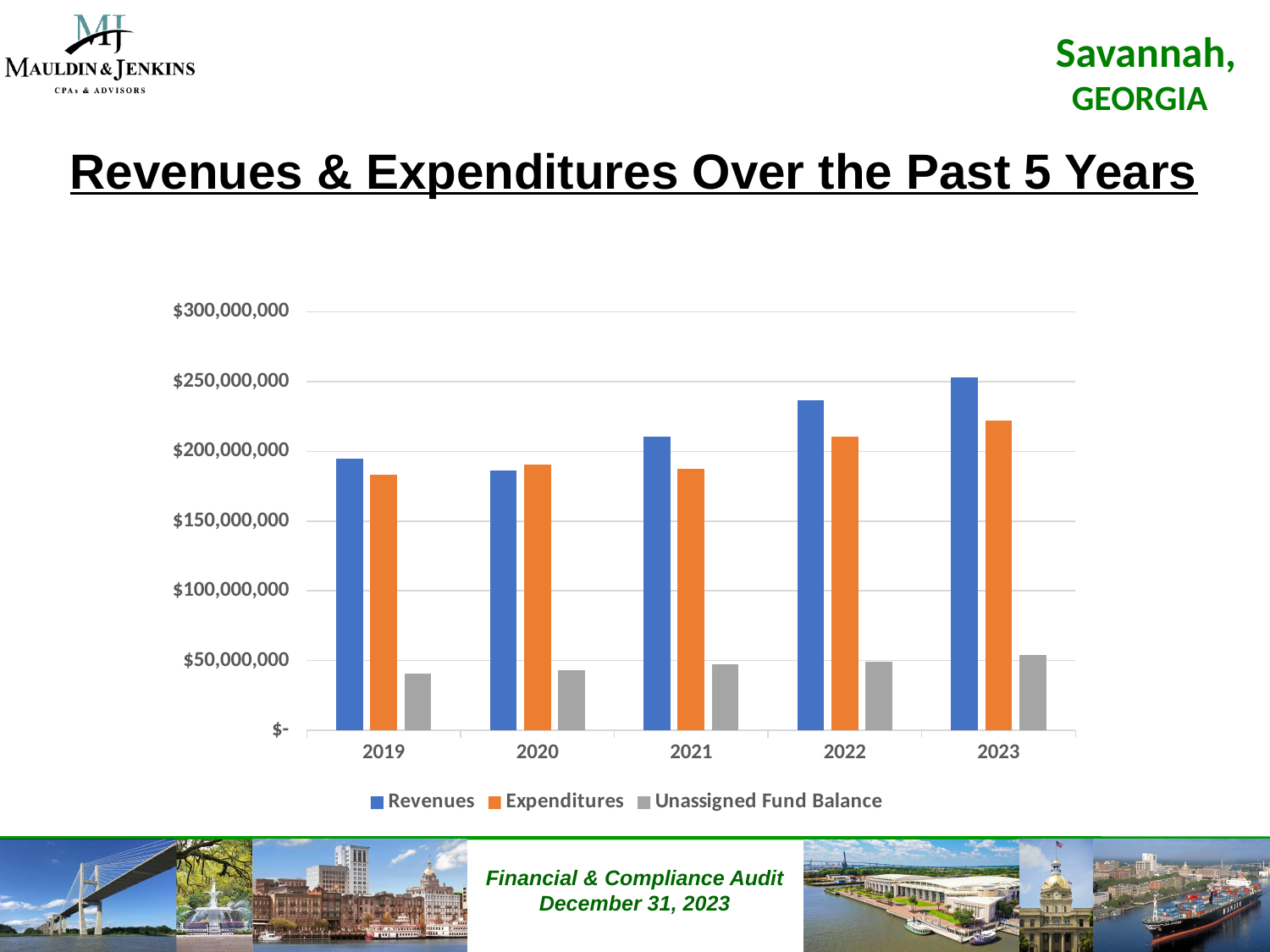
How many series does the legend list? 3 Which year has the highest Expenditures? 2023 Is the value for Expenditures in 2019 greater or less than $200,000,000? less Do the Unassigned Fund Balance values rise or fall from 2019 to 2023? Rise Is the value for Unassigned Fund Balance in 2019 greater or less than $50,000,000? less In 2022, which is larger, Revenues or Expenditures? Revenues What colour represents Expenditures in the chart? Orange How many years are shown on the x axis? 5 Is the value for Revenues in 2023 greater or less than $200,000,000? greater What kind of chart is shown on the slide? Bar chart Which year has the lowest Revenues? 2020 Which year has the highest Revenues? 2023